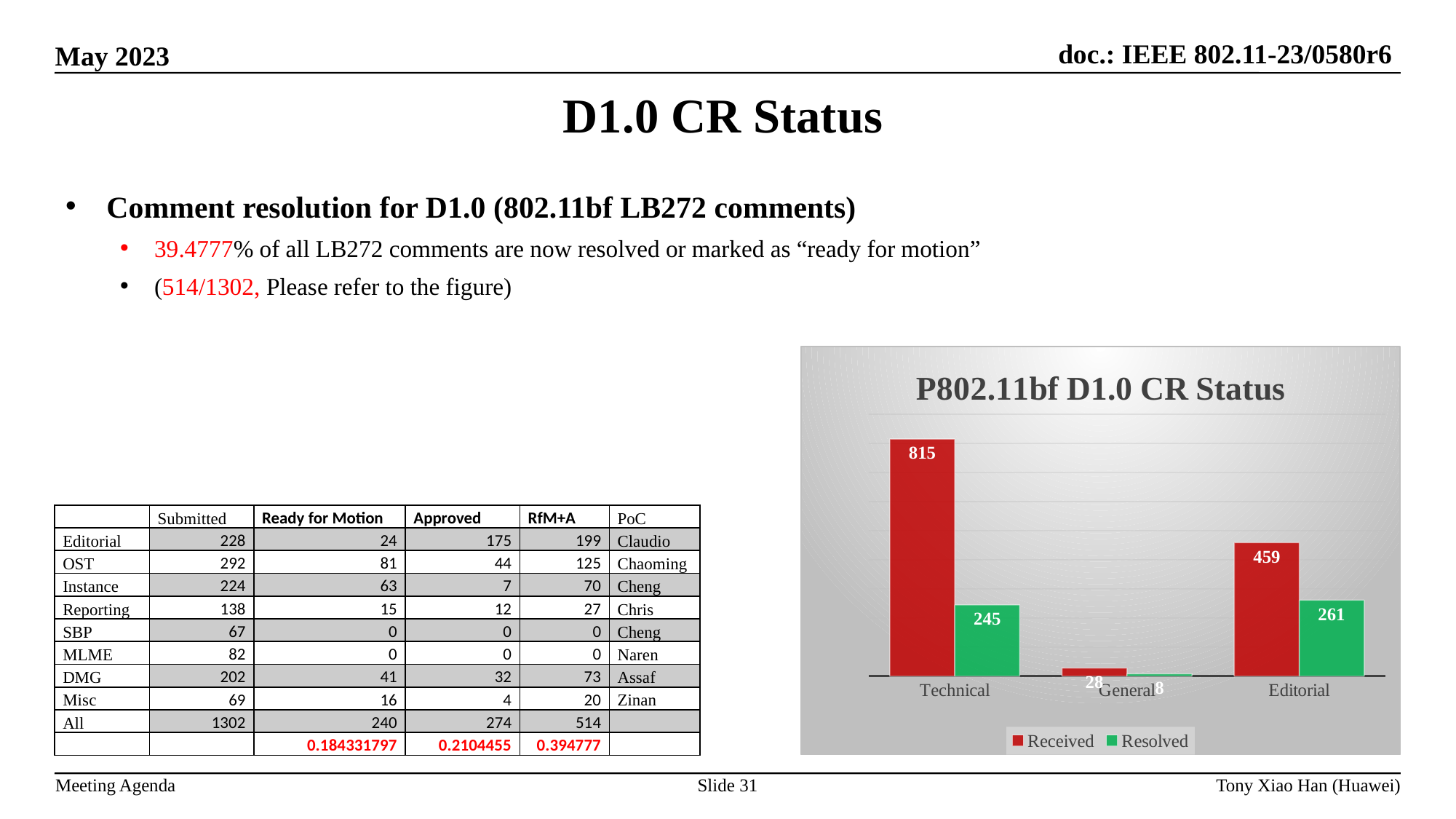
Which is larger, the Resolved value for Editorial or the Resolved value for Technical? Editorial What is the Received value for General? 28 How many series does the chart legend list? 2 What is the difference between Received and Resolved for Technical? 570 How many categories are shown on the x axis of the chart? 3 Which category has the highest Received value? Technical Which colour represents the Resolved series in the chart? green What is the Received value for Technical? 815 What is the title of the chart? P802.11bf D1.0 CR Status Which category has the lowest Resolved value? General What type of chart is shown on the slide? bar chart What is the Resolved value for Editorial? 261